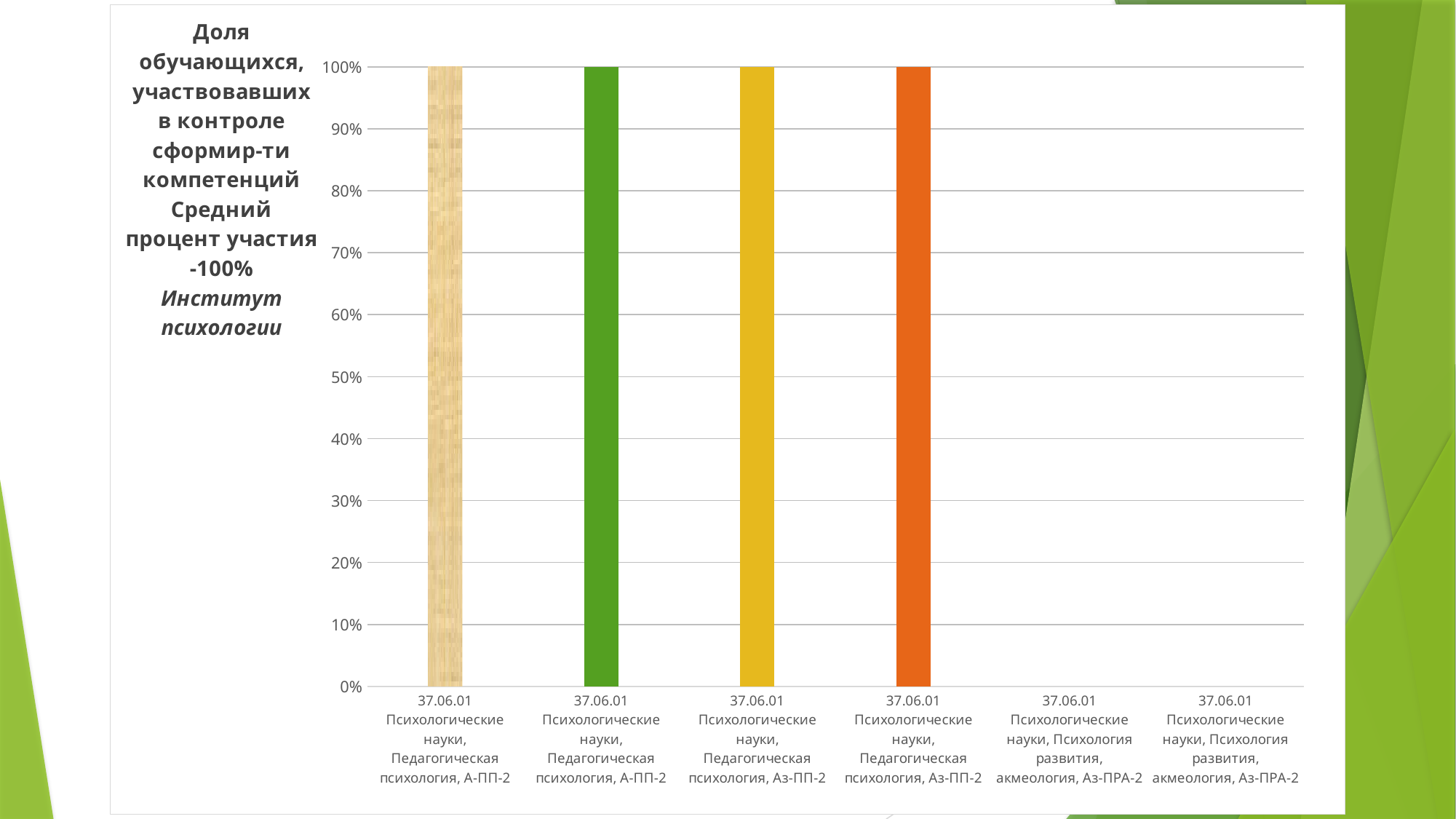
What is the value of the orange bar (fourth from the left) in the chart? 100% Which institute is named in the chart title on the slide? Институт психологии What is the value of the yellow bar (third from the left) in the chart? 100% How many bars are visibly plotted in the chart? 4 Is the value of the leftmost beige bar greater or less than 90%? greater What colour is the second bar from the left in the chart? green Is the value of the orange bar greater or less than 50%? greater What kind of chart is shown on the slide? bar chart What is the value of the first (leftmost, beige) bar in the chart? 100% How many categories are listed along the x axis of the chart? 6 What is the value of the green bar (second from the left) in the chart? 100%